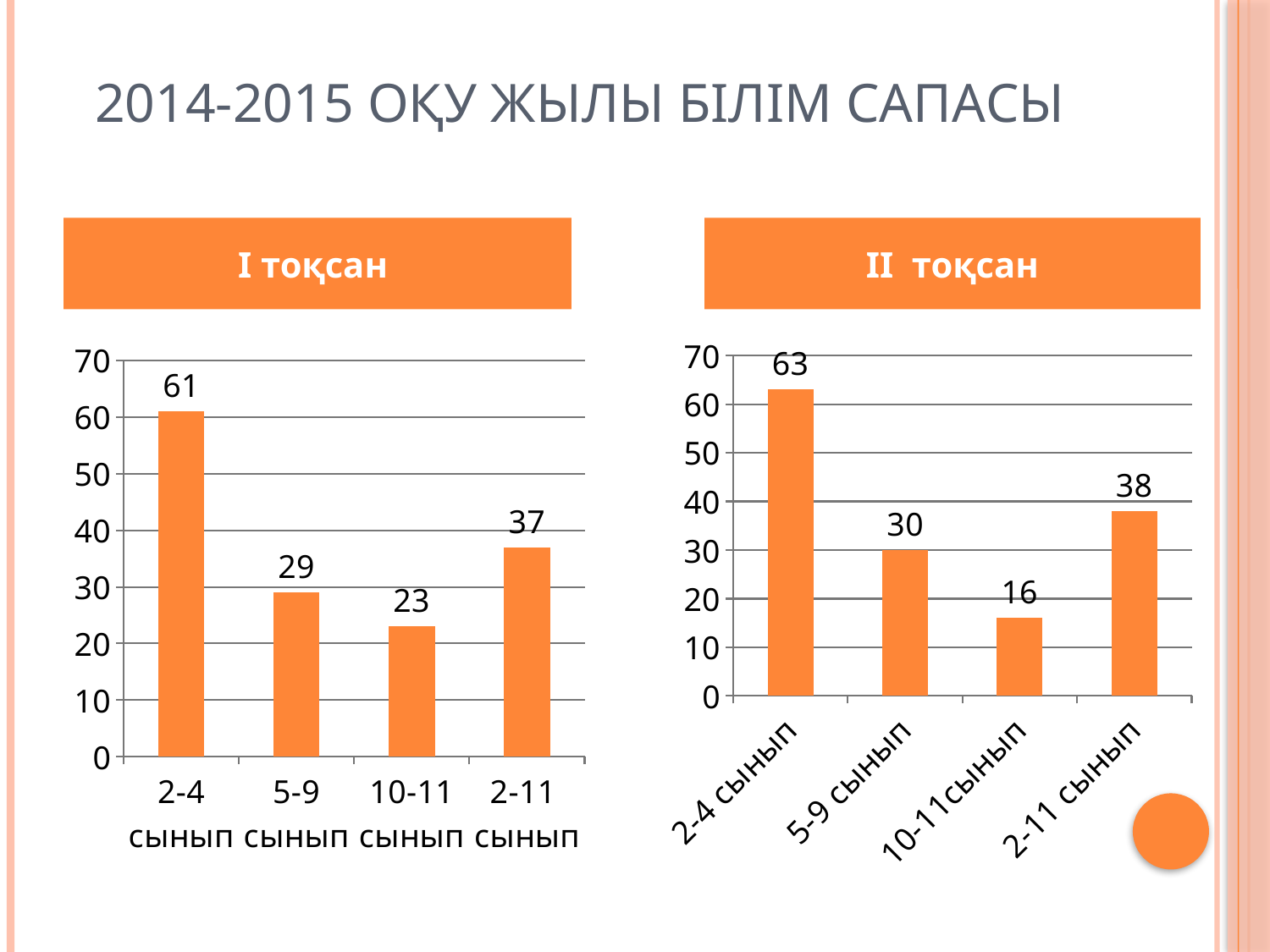
What is the title of the chart on the right? II тоқсан What kind of chart is the I тоқсан chart? bar chart Which is larger: the value for 2-11 сынып in the I тоқсан chart or in the II тоқсан chart? II тоқсан In the II тоқсан chart, what is the value for 10-11 сынып? 16 In the II тоқсан chart, which category has the highest value? 2-4 сынып In the I тоқсан chart, what is the difference between the values for 2-4 сынып and 5-9 сынып? 32 How many categories are shown in the II тоқсан chart? 4 In the I тоқсан chart, is the value for 5-9 сынып greater or less than 30? less In the II тоқсан chart, what is the difference between the values for 2-11 сынып and 10-11 сынып? 22 In the I тоқсан chart, what is the value for 2-4 сынып? 61 In the I тоқсан chart, what is the value for 2-11 сынып? 37 In the I тоқсан chart, which category has the lowest value? 10-11 сынып